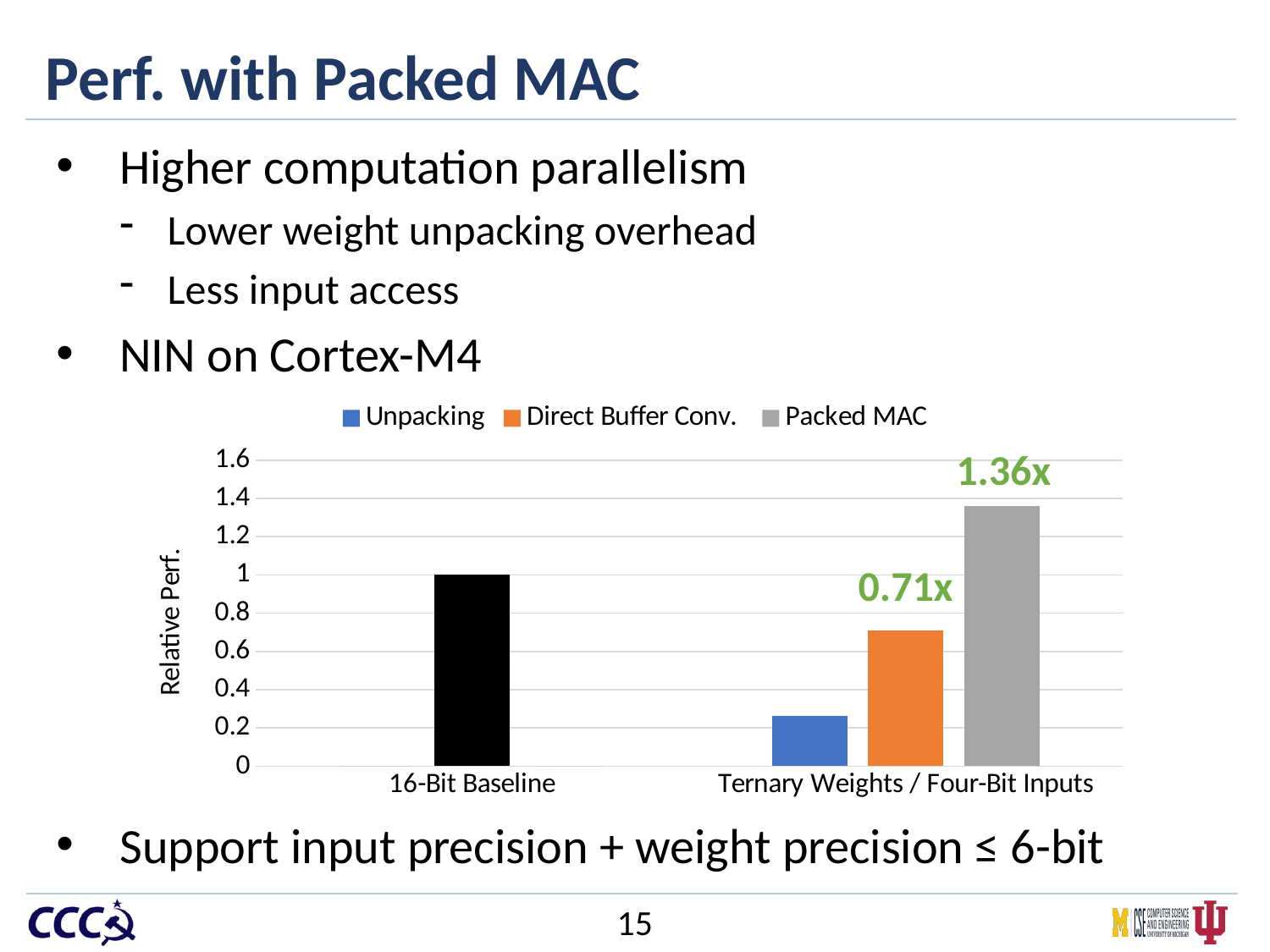
What kind of chart is shown on the slide? bar chart What is the difference between the Packed MAC value (1.36x) and the Direct Buffer Conv. value (0.71x)? 0.65x What is the relative performance of the 16-Bit Baseline bar? 1 Which series has the lowest bar in the Ternary Weights / Four-Bit Inputs category? Unpacking Is the value for Unpacking under Ternary Weights / Four-Bit Inputs greater or less than 0.4? less Which series has the highest bar in the Ternary Weights / Four-Bit Inputs category? Packed MAC What is the relative performance labelled for Packed MAC under Ternary Weights / Four-Bit Inputs? 1.36x What is the label on the y axis of the chart? Relative Perf. How many categories are shown on the x axis of the chart? 2 Which is larger: the Packed MAC bar or the 16-Bit Baseline bar? Packed MAC What is the relative performance labelled for Direct Buffer Conv. under Ternary Weights / Four-Bit Inputs? 0.71x How many series does the chart legend list? 3